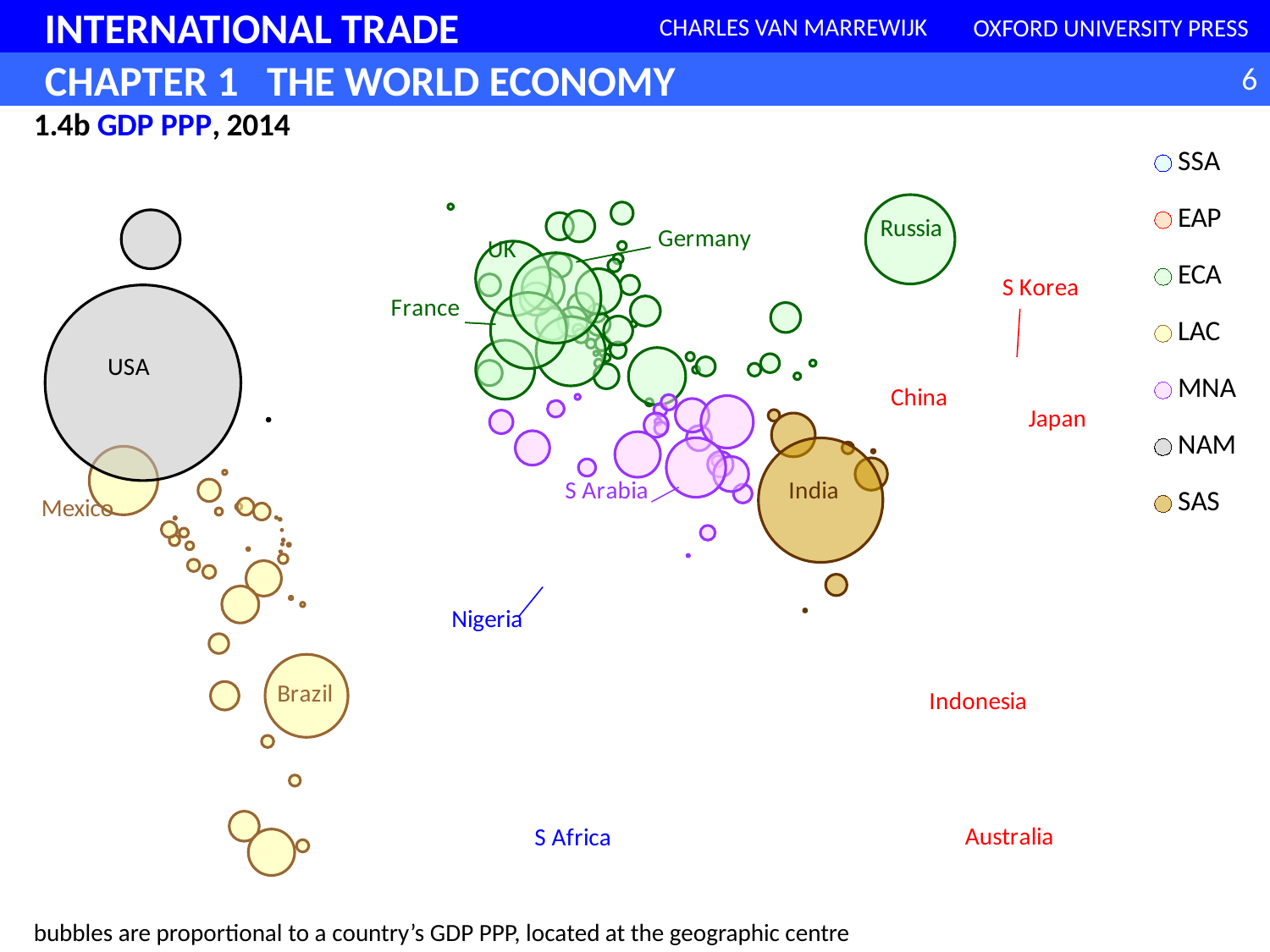
Which legend region does the Russia bubble belong to? ECA Which bubble is larger, USA or Russia? USA What is the title of the chart? 1.4b GDP PPP, 2014 Which legend region does the Brazil bubble belong to? LAC According to the note below the chart, what are the bubbles proportional to? a country's GDP PPP Which country has the largest bubble on the chart? USA How many regions does the legend list? 7 Which legend region does the India bubble belong to? SAS Which bubble is larger, Brazil or Mexico? Brazil Which bubble is larger, India or Mexico? India What kind of chart is shown on the slide? bubble chart